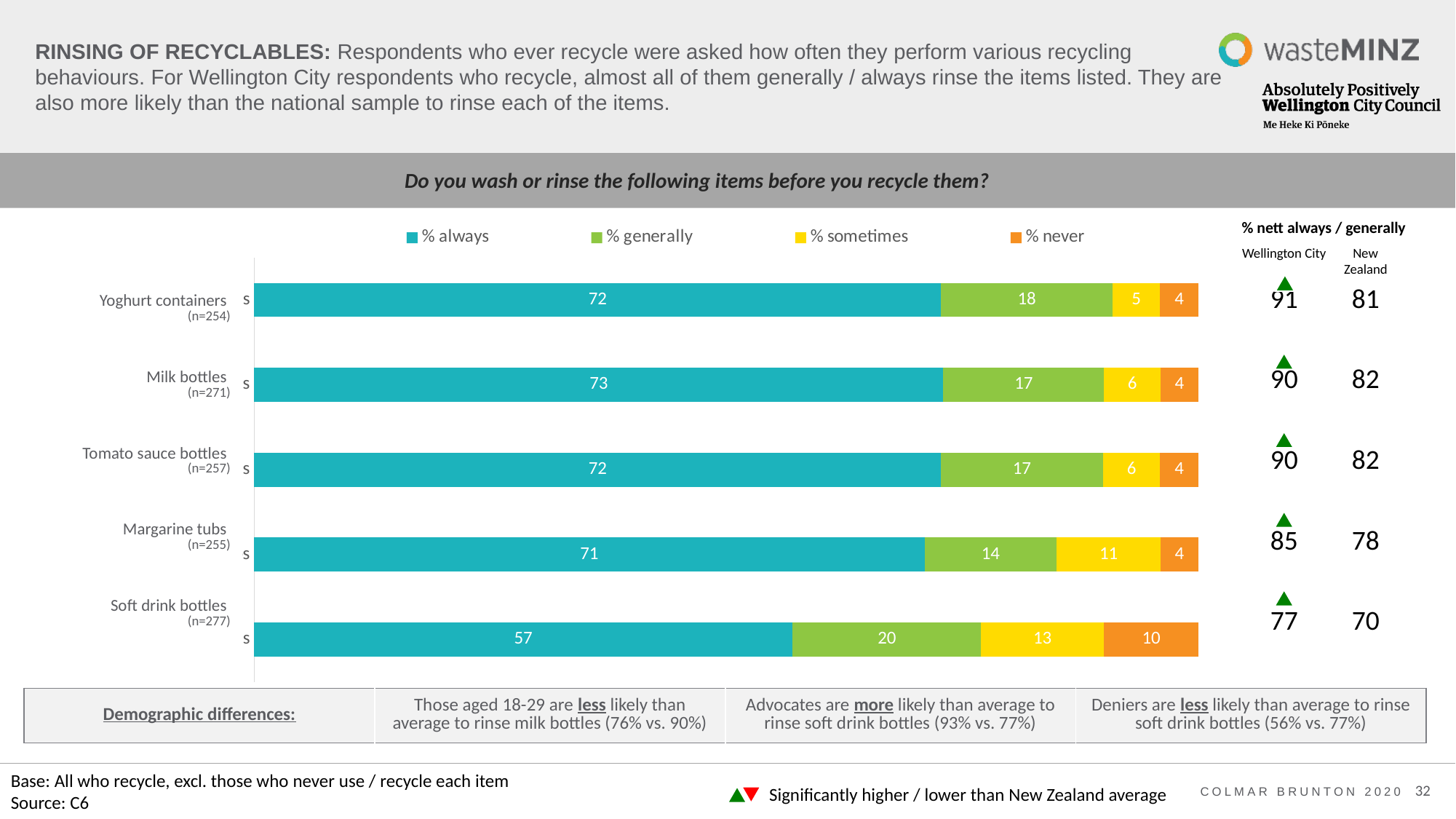
What is the '% generally' value for Soft drink bottles? 20 Which has the larger '% sometimes' value, Margarine tubs or Milk bottles? Margarine tubs What is the '% always' value for Milk bottles? 73 What kind of chart is shown on the slide? Stacked bar chart What is the total of the stacked bar for Yoghurt containers? 99 How many series does the legend list? 4 Which item has the highest '% always' value? Milk bottles What is the difference between the '% always' values for Yoghurt containers and Soft drink bottles? 15 How many items are shown in the chart? 5 What colour represents '% never' in the legend? Orange What is the '% never' value for Soft drink bottles? 10 Which item has the lowest '% always' value? Soft drink bottles